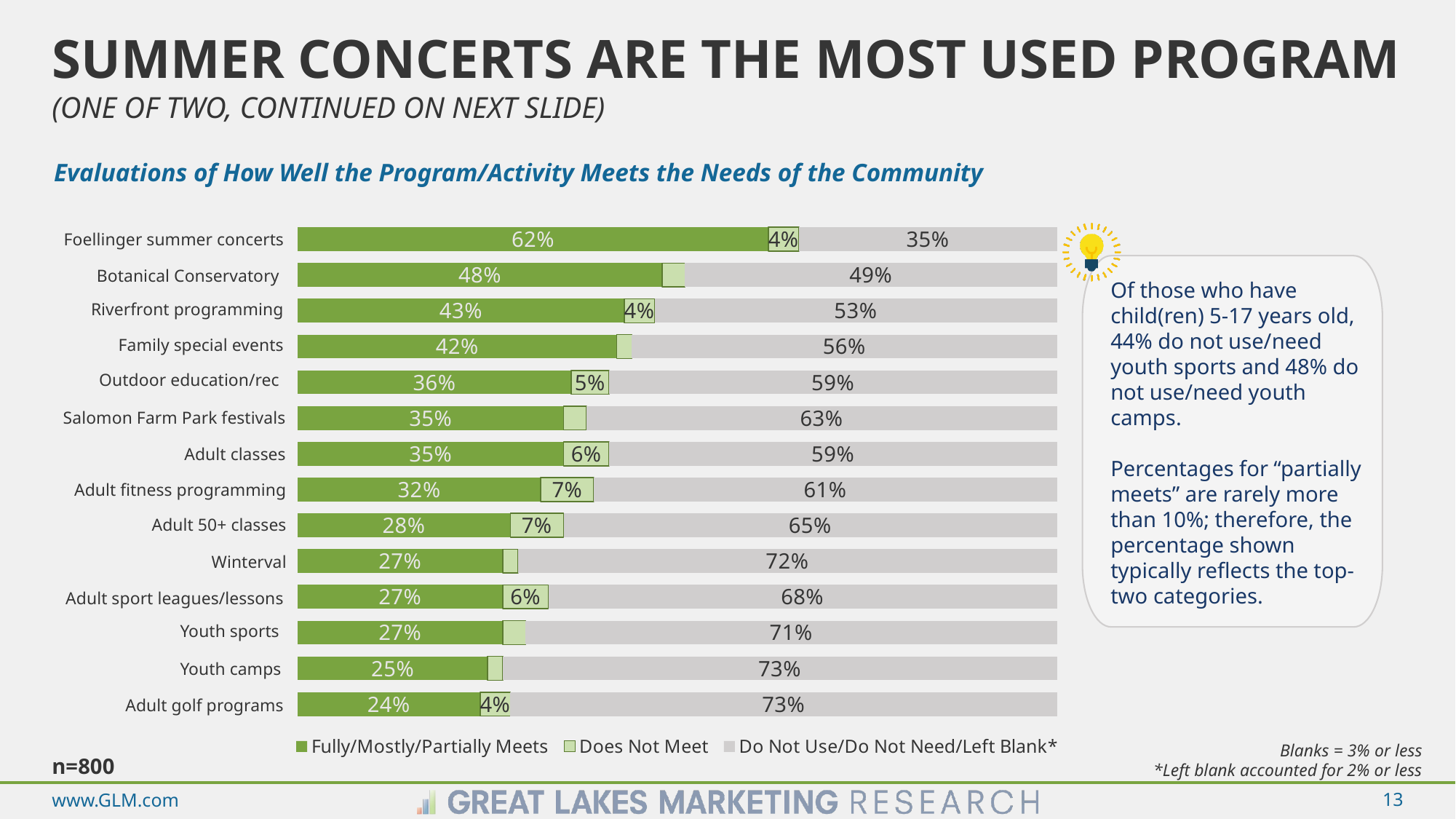
How many series does the chart legend list? 3 What type of chart is shown on the slide? Stacked bar chart What is the Do Not Use/Do Not Need/Left Blank* value for Winterval? 72% What is the Does Not Meet value for Adult 50+ classes? 7% How many percentage points higher is the Fully/Mostly/Partially Meets value for Botanical Conservatory than for Riverfront programming? 5 percentage points What percentage of respondents said Foellinger summer concerts Fully/Mostly/Partially Meets the needs of the community? 62% What is the title of the chart? Evaluations of How Well the Program/Activity Meets the Needs of the Community What is the difference between the Do Not Use/Do Not Need/Left Blank* values for Winterval and Adult sport leagues/lessons? 4 percentage points Which has a larger Do Not Use/Do Not Need/Left Blank* value: Adult fitness programming or Adult 50+ classes? Adult 50+ classes How many programs/activities are listed in the chart? 14 Which program has the lowest Fully/Mostly/Partially Meets percentage? Adult golf programs Which program has the highest Fully/Mostly/Partially Meets percentage? Foellinger summer concerts